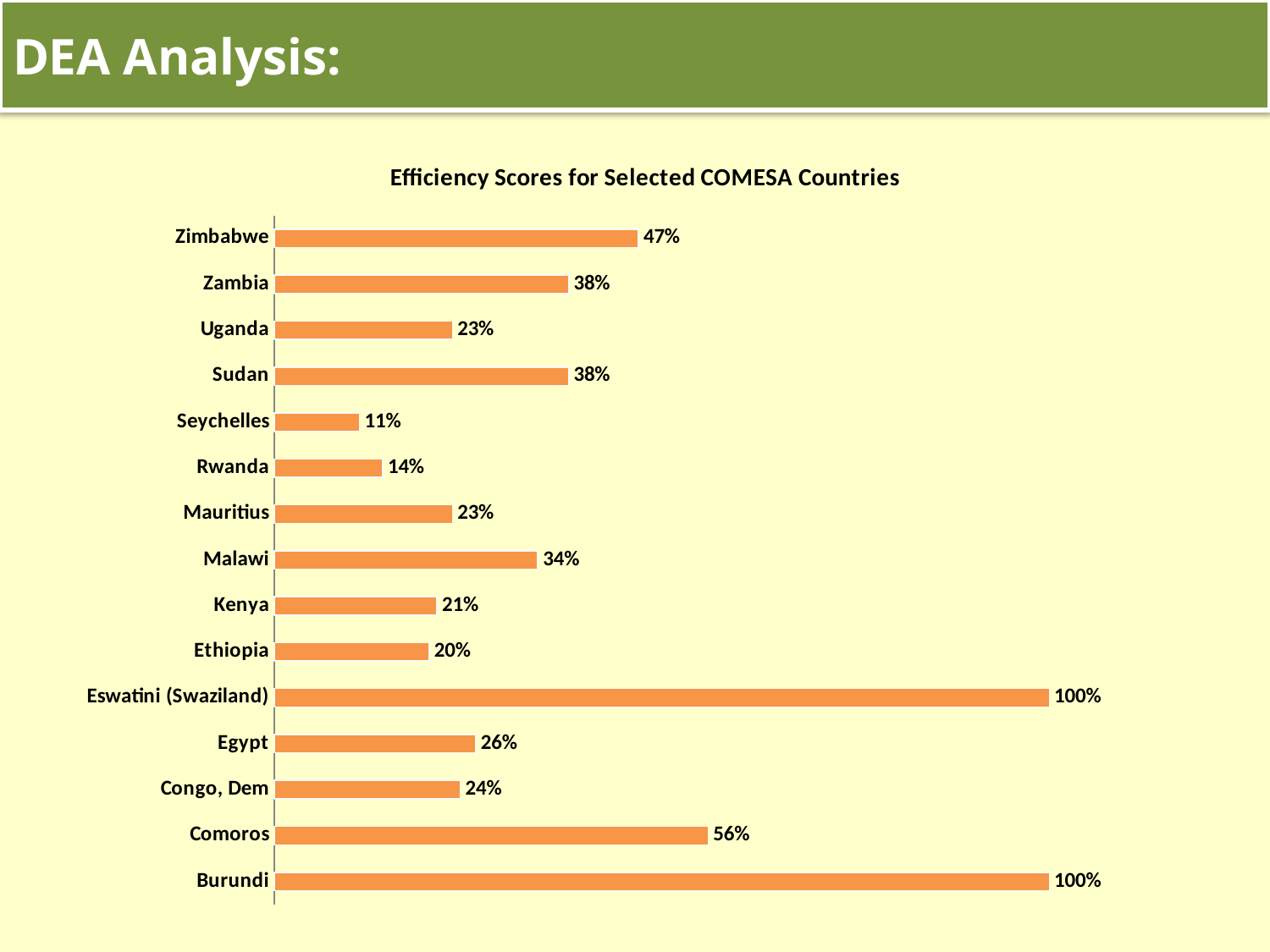
What is the difference between the efficiency scores of Comoros and Congo, Dem? 32% What is the efficiency score for Comoros? 56% What is the efficiency score for Seychelles? 11% Which two countries have the highest efficiency score of 100%? Eswatini (Swaziland) and Burundi Which has a higher efficiency score, Rwanda or Kenya? Kenya Which has a higher efficiency score, Malawi or Egypt? Malawi What is the efficiency score for Zimbabwe? 47% What is the difference between the efficiency scores of Zimbabwe and Zambia? 9% How many countries are shown in the chart? 15 What type of chart is shown on the slide? Bar chart What is the title of the chart? Efficiency Scores for Selected COMESA Countries Which country has the lowest efficiency score? Seychelles